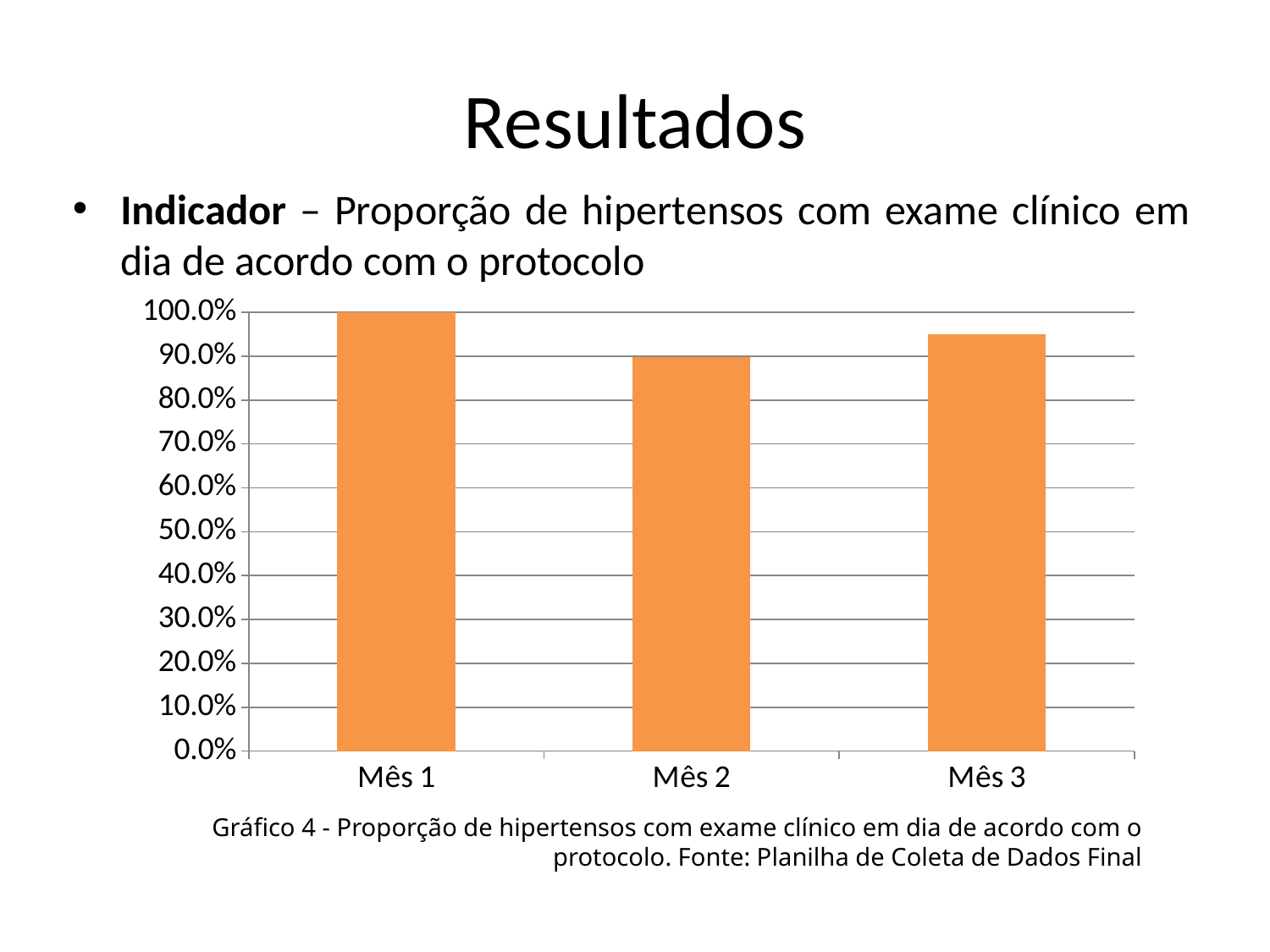
Does the value rise or fall from Mês 1 to Mês 2? fall What colour are the bars in the chart? orange How many months are shown on the x axis? 3 Which month has the highest value? Mês 1 Which is larger, the value for Mês 3 or the value for Mês 2? Mês 3 Is the value for Mês 3 greater or less than 100.0%? less What kind of chart is shown on the slide? bar chart Which month has the lowest value? Mês 2 What is the value for Mês 1? 100.0% Is the value for Mês 3 greater or less than 90.0%? greater